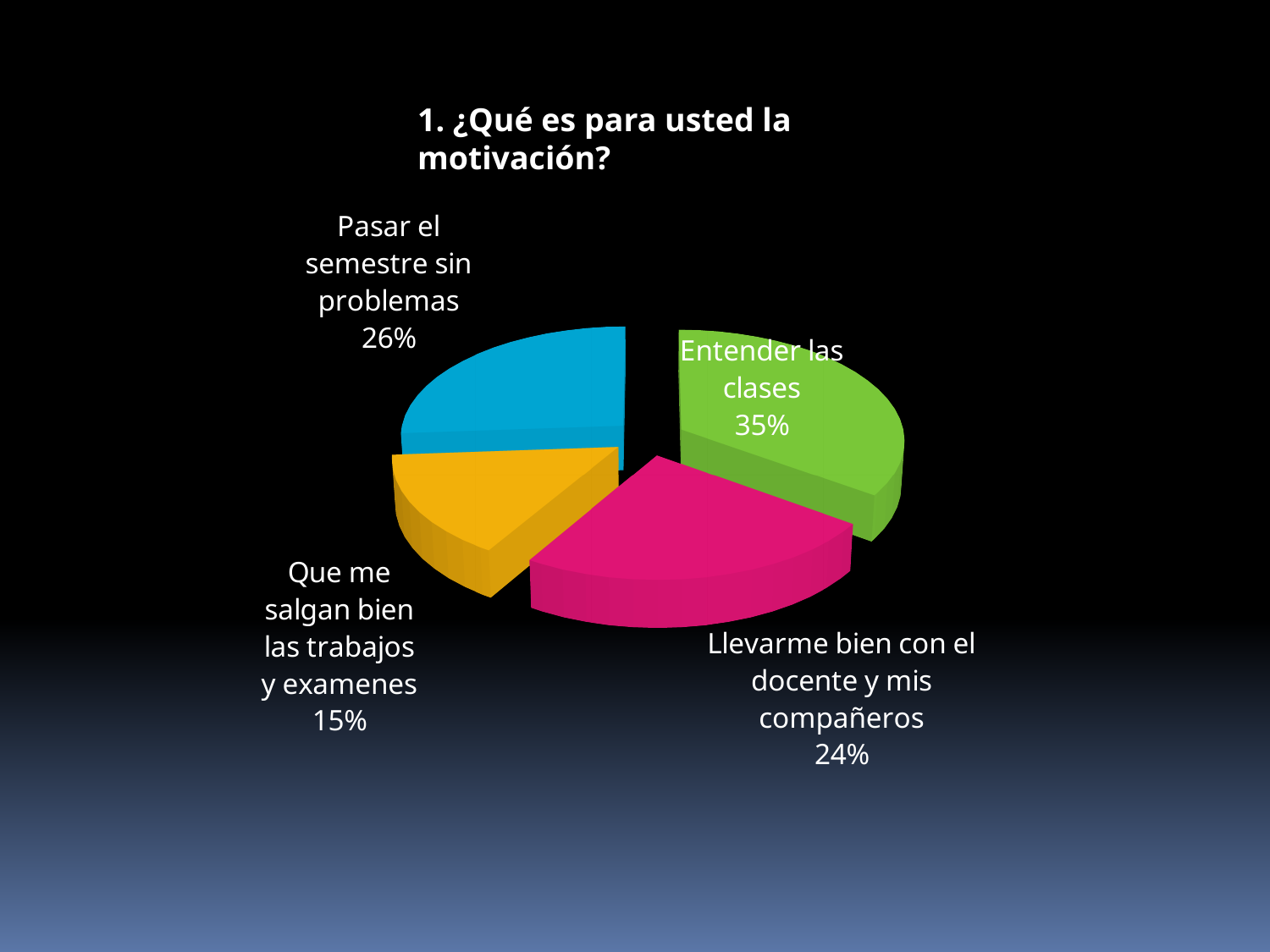
Which category has the largest slice of the pie? Entender las clases What share of the pie does "Entender las clases" represent? 35% How many slices does the pie chart have? 4 Which category has the smallest slice of the pie? Que me salgan bien las trabajos y examenes What is the title of the chart? 1. ¿Qué es para usted la motivación? Which is larger: the slice for "Pasar el semestre sin problemas" or the slice for "Llevarme bien con el docente y mis compañeros"? Pasar el semestre sin problemas What is the difference in percentage points between "Entender las clases" and "Que me salgan bien las trabajos y examenes"? 20 What share of the pie does "Llevarme bien con el docente y mis compañeros" represent? 24% What share of the pie does "Que me salgan bien las trabajos y examenes" represent? 15% What colour is the slice for "Entender las clases"? Green What kind of chart is shown on the slide? Pie chart